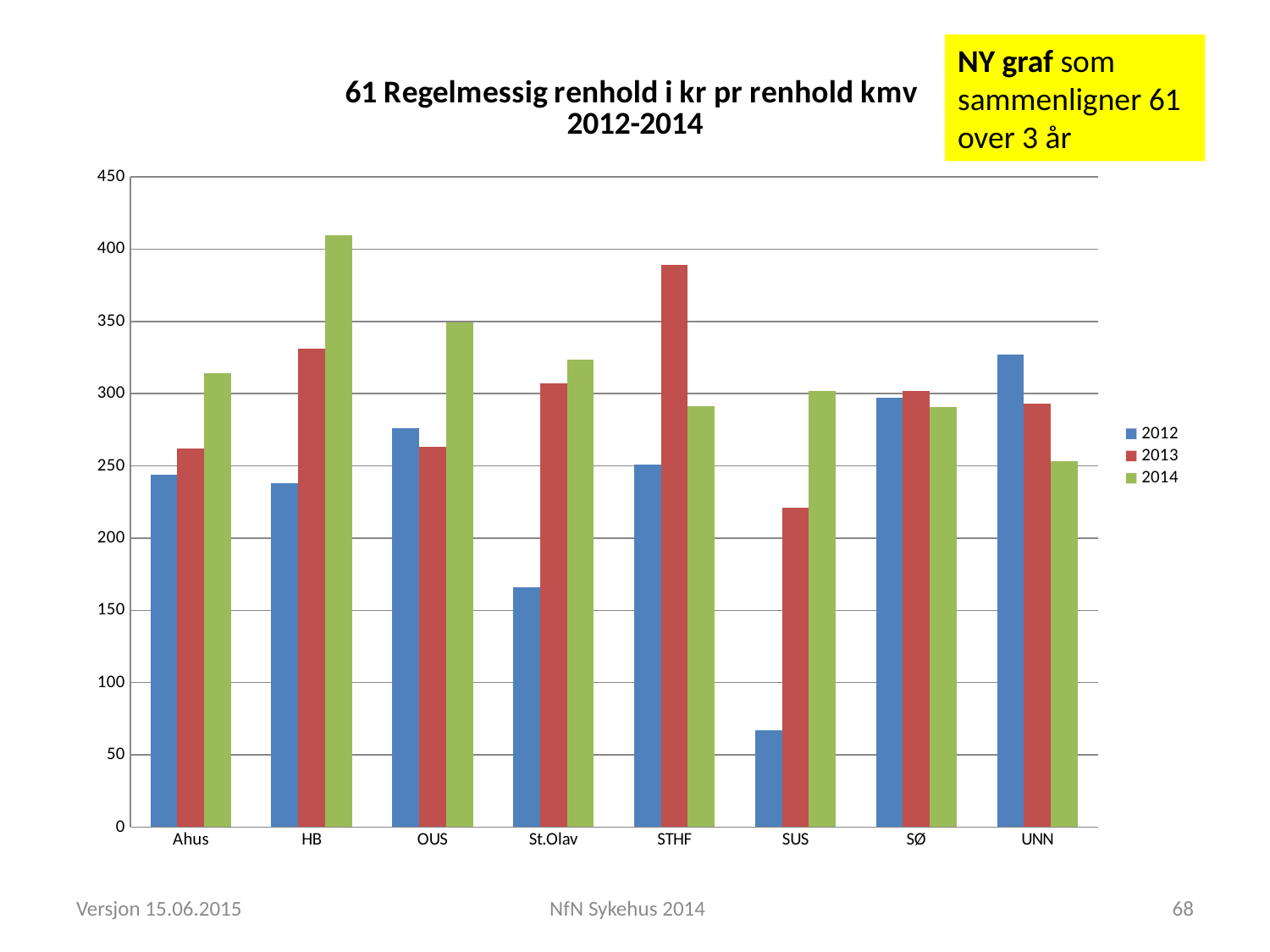
Which category has the highest value for 2014? HB How many categories (hospitals) are shown on the x axis? 8 Which category has the lowest value for 2012? SUS What is the title of the chart? 61 Regelmessig renhold i kr pr renhold kmv 2012-2014 What kind of chart is shown on the slide? Bar chart Is the 2014 value for HB greater or less than 400? greater Is the 2012 value for SUS greater or less than 100? less Which category has the highest value for 2013? STHF How many series does the legend list? 3 Do the values for Ahus rise or fall from 2012 to 2014? rise For UNN, which is larger: the 2012 value or the 2014 value? 2012 For St.Olav, which is larger: the 2012 value or the 2013 value? 2013